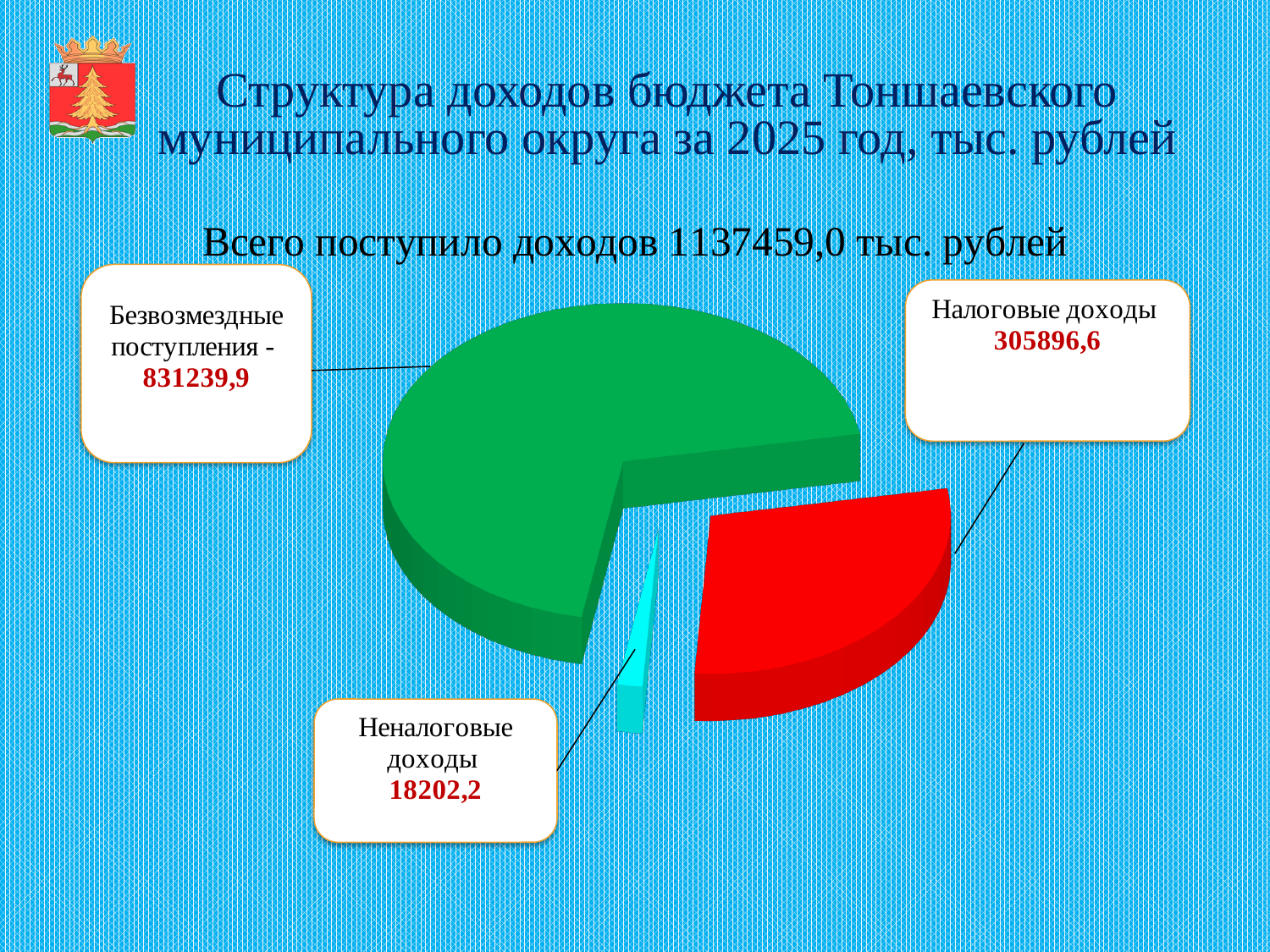
What is the value for Неналоговые доходы? 18202,2 What type of chart is shown on the slide? Pie chart What is the difference between Безвозмездные поступления and Налоговые доходы? 525343,3 Which is larger, Налоговые доходы or Неналоговые доходы? Налоговые доходы What is the value for Налоговые доходы? 305896,6 What total income amount is stated on the slide? 1137459,0 тыс. рублей How many slices does the pie chart have? 3 Which category has the smallest slice of the pie? Неналоговые доходы What colour is the slice for Налоговые доходы? Red What is the value for Безвозмездные поступления? 831239,9 Which category has the largest slice of the pie? Безвозмездные поступления What is the difference between Налоговые доходы and Неналоговые доходы? 287694,4